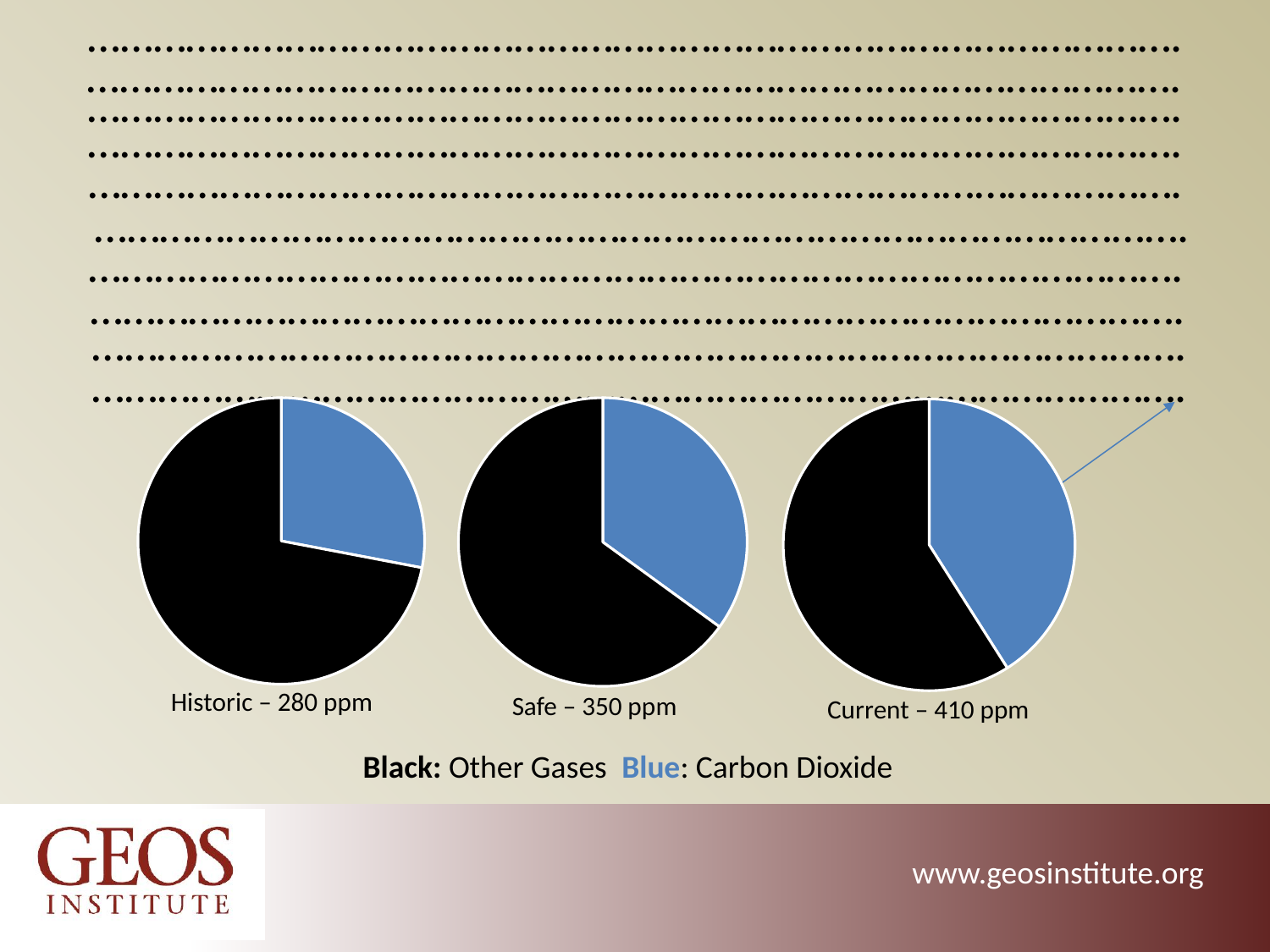
Is the blue (Carbon Dioxide) slice larger in the Current pie chart or the Historic pie chart? Current According to the legend text, what does the black slice represent? Other Gases According to the legend text, what does the blue slice represent? Carbon Dioxide What ppm value is given for the Current pie chart? 410 ppm What is the difference in ppm between the Current and Historic pie charts? 130 ppm How many pie charts are on the slide? 3 What kind of charts are shown on the slide? Pie charts What ppm value is given for the Historic pie chart? 280 ppm How many slices does each pie chart have? 2 Which pie chart has the largest blue (Carbon Dioxide) slice? Current – 410 ppm Which pie chart has the smallest blue (Carbon Dioxide) slice? Historic – 280 ppm What ppm value is given for the Safe pie chart? 350 ppm